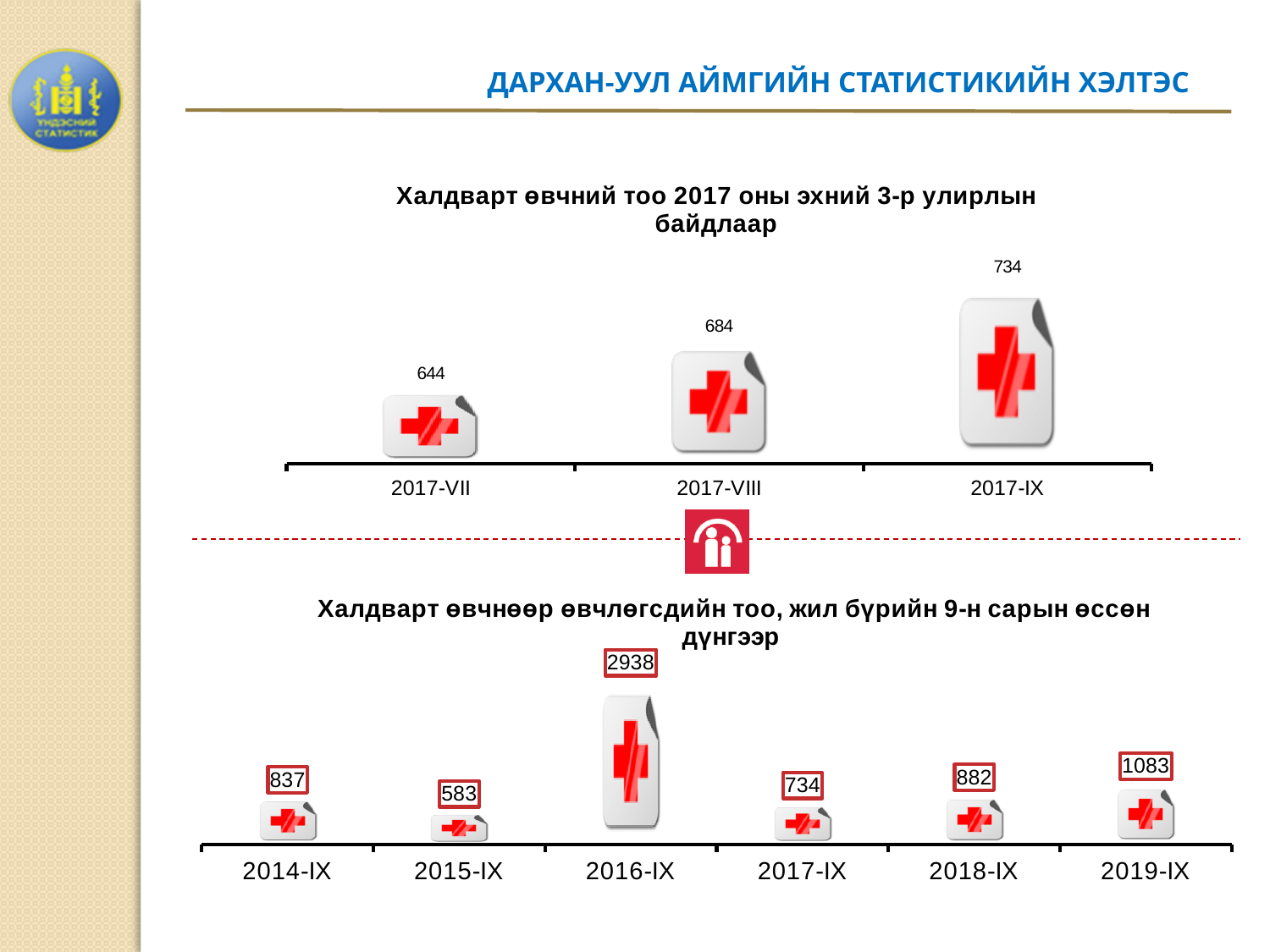
In the bottom chart, what is the value for 2016-IX? 2938 In the bottom chart, which year has the lowest value? 2015-IX In the top chart, do the values rise or fall from 2017-VII to 2017-IX? rise In the bottom chart, which is larger, the value for 2018-IX or the value for 2017-IX? 2018-IX In the top chart, what is the difference between the values for 2017-IX and 2017-VII? 90 In the top chart, what is the value for 2017-VII? 644 In the bottom chart, how many years are shown on the x axis? 6 In the top chart, which month has the highest value? 2017-IX In the top chart, what is the value for 2017-VIII? 684 In the top chart, how many months are shown? 3 In the bottom chart, what is the value for 2019-IX? 1083 In the bottom chart, what is the difference between the values for 2019-IX and 2018-IX? 201